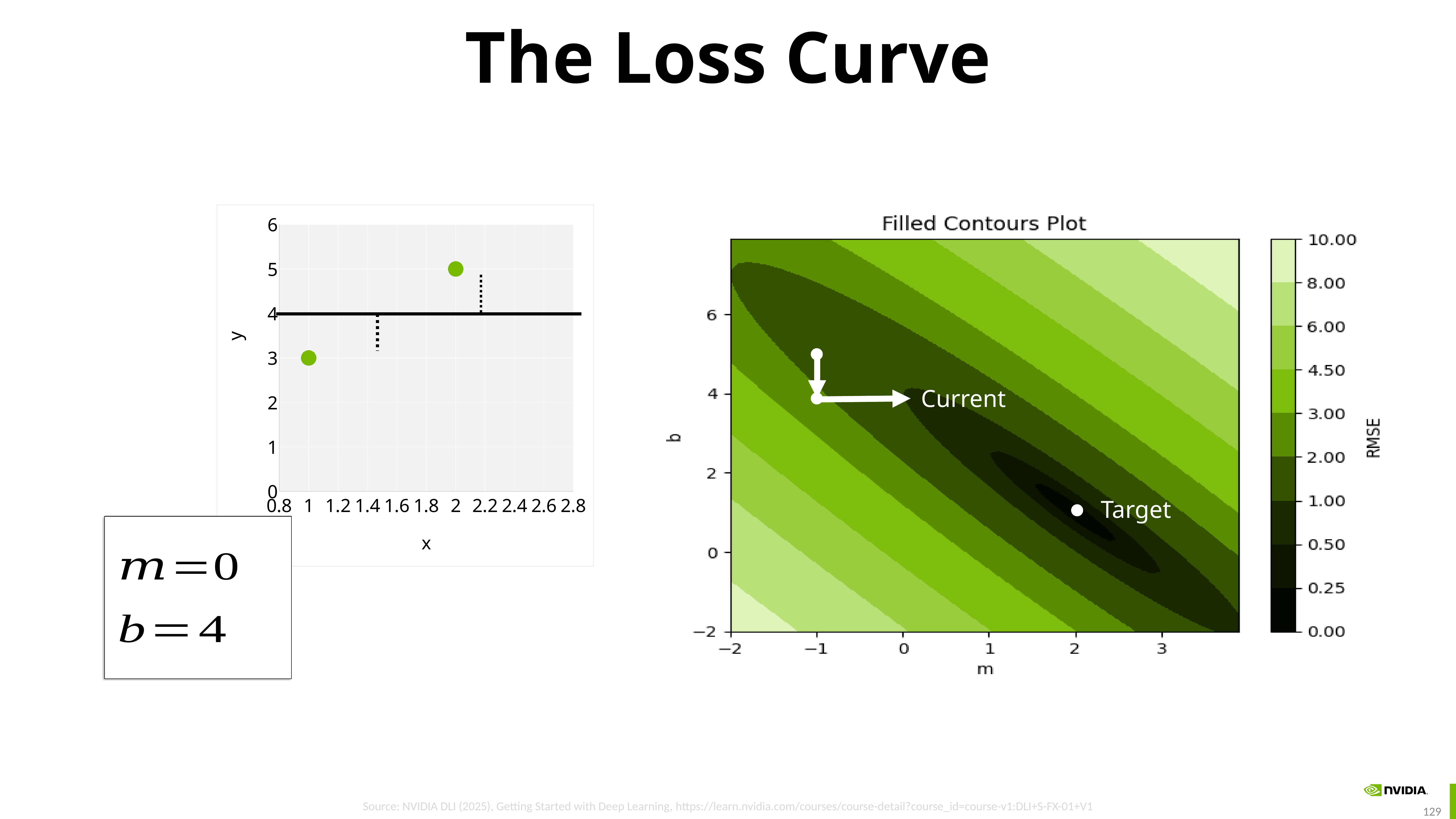
In the left chart, which data point has the higher y value, the one at x = 1 or the one at x = 2? x = 2 In the right chart, what quantity does the colour bar represent? RMSE In the left chart, what is the y value of the data point at x = 2? 5 In the left chart, what is the difference in y between the point at x = 2 and the point at x = 1? 2 In the left chart, what is the y value of the data point at x = 1? 3 In the left chart, at what y value is the horizontal black line drawn? 4 In the left chart, do the y values of the data points rise or fall as x increases? rise In the right chart, is the b value of the Target point greater or less than 2? less What kind of chart is the left chart? scatter plot In the left chart, how many green data points are plotted? 2 What is the title of the right chart? Filled Contours Plot In the right chart, what is the highest value shown on the RMSE colour bar? 10.00